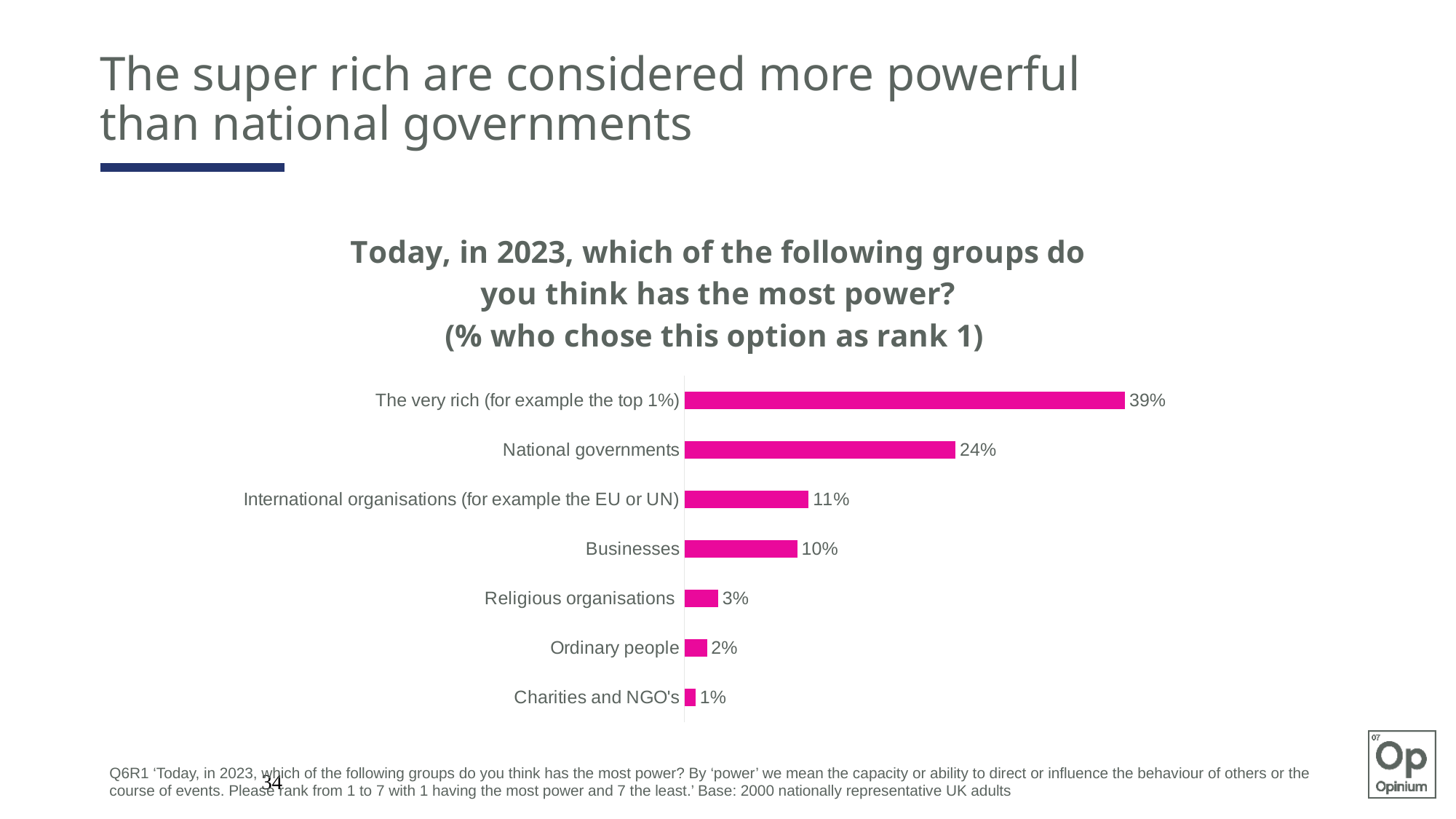
Which group has the highest percentage? The very rich (for example the top 1%) What percentage chose 'The very rich (for example the top 1%)' as having the most power? 39% What is the value for 'International organisations (for example the EU or UN)'? 11% Which group has the lowest percentage? Charities and NGO's What colour are the bars in the chart? Pink Which has a larger value, 'Businesses' or 'Religious organisations'? Businesses What is the value for 'Charities and NGO's'? 1% How many groups are shown in the chart? 7 What kind of chart is shown on the slide? Bar chart What percentage chose 'National governments' as rank 1? 24% What is the difference between the values for 'The very rich (for example the top 1%)' and 'National governments'? 15% What is the difference between the values for 'International organisations (for example the EU or UN)' and 'Businesses'? 1%